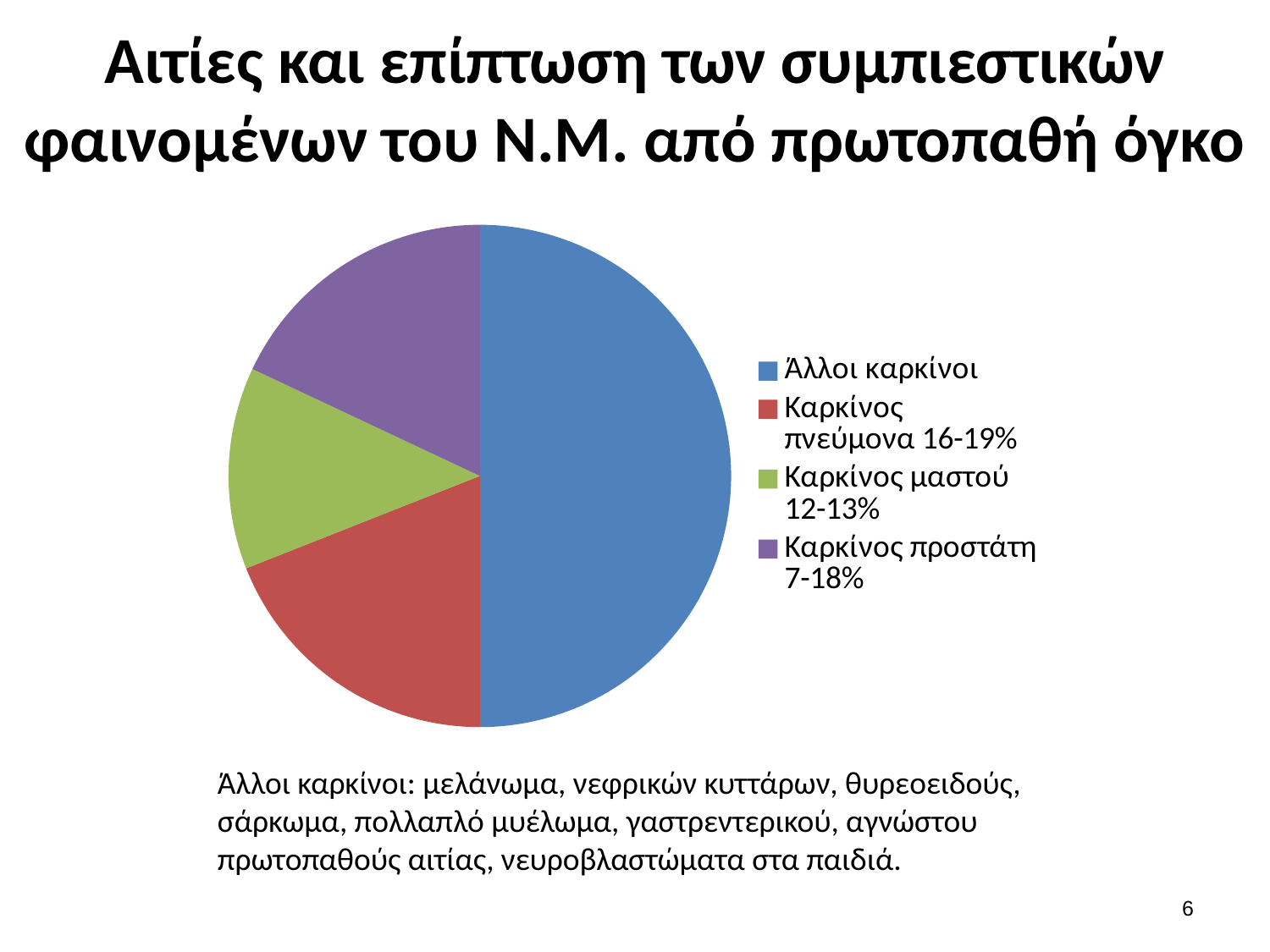
Which slice is larger: Καρκίνος πνεύμονα 16-19% or Καρκίνος μαστού 12-13%? Καρκίνος πνεύμονα 16-19% How many entries does the legend of the pie chart list? 4 How many slices does the pie chart have? 4 Which colour represents Καρκίνος μαστού 12-13% in the pie chart? green Which category has the smallest slice of the pie chart? Καρκίνος μαστού 12-13% Which category has the largest slice of the pie chart? Άλλοι καρκίνοι Which legend entry is shown in blue? Άλλοι καρκίνοι Which slice is larger: Καρκίνος προστάτη 7-18% or Καρκίνος μαστού 12-13%? Καρκίνος προστάτη 7-18% Which slice is larger: Άλλοι καρκίνοι or Καρκίνος πνεύμονα 16-19%? Άλλοι καρκίνοι What kind of chart is shown on the slide? pie chart